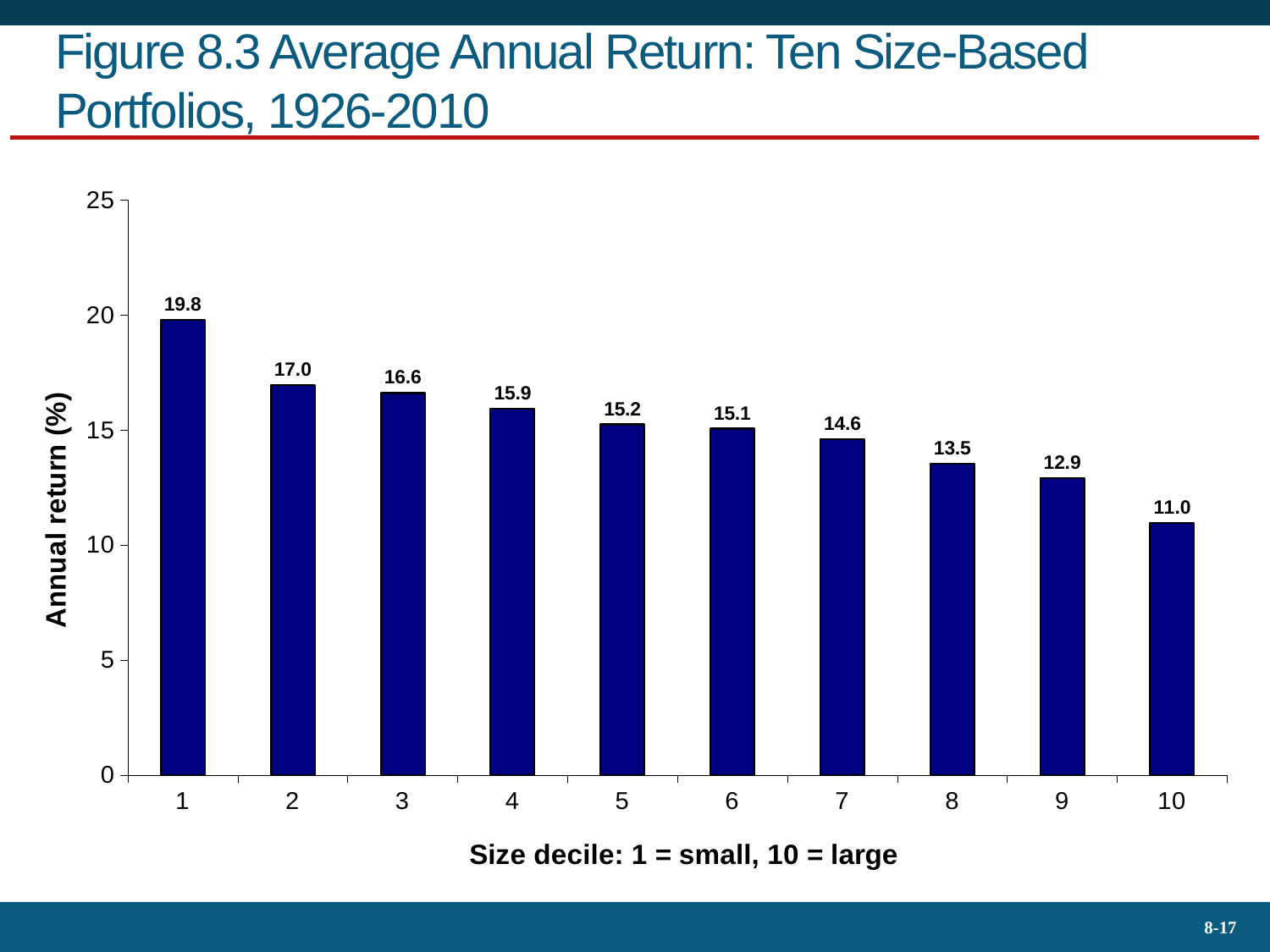
What kind of chart is shown on the slide? Bar chart How many size deciles are shown on the chart? 10 Which has a higher average annual return, decile 4 or decile 8? Decile 4 Which size decile has the highest average annual return? 1 What is the average annual return for size decile 10? 11.0 What is the average annual return for size decile 1? 19.8 Which size decile has the lowest average annual return? 10 Is the average annual return for decile 9 greater or less than 15? less What is the average annual return for size decile 5? 15.2 What is the difference in average annual return between decile 1 and decile 10? 8.8 Do the average annual returns rise or fall as the size decile increases from 1 to 10? Fall What is the difference in average annual return between decile 2 and decile 3? 0.4